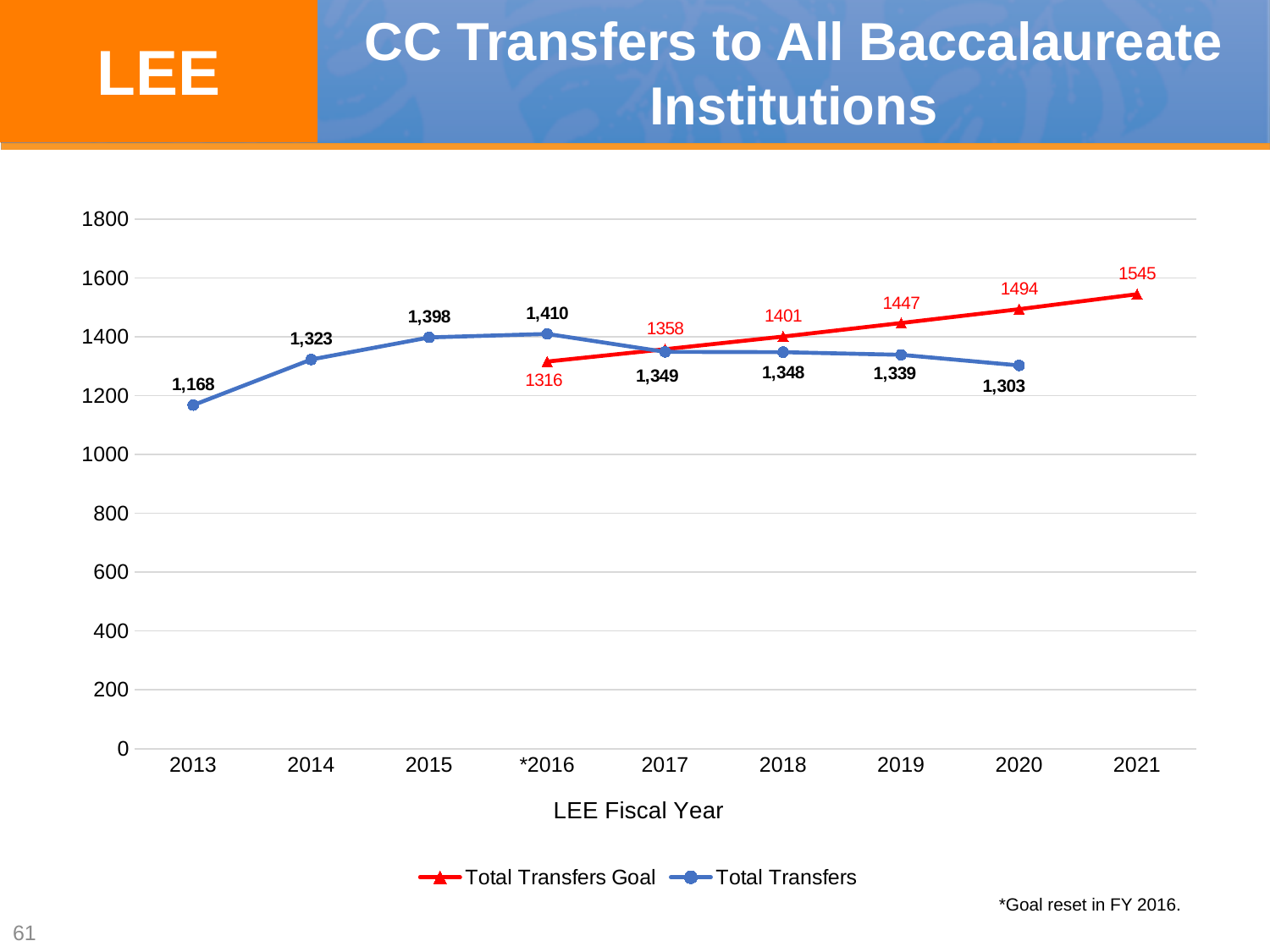
What is the Total Transfers value for 2013? 1,168 How many years are shown on the x axis? 9 Is the Total Transfers value for 2015 greater or less than 1200? greater What kind of chart is shown on the slide? Line chart How many series does the legend list? 2 In which year is Total Transfers lowest? 2013 Which is larger in 2019, Total Transfers Goal or Total Transfers? Total Transfers Goal In which year is Total Transfers highest? *2016 What is the difference between the Total Transfers Goal and Total Transfers in 2020? 191 What is the Total Transfers value for 2020? 1,303 What is the Total Transfers Goal value for 2021? 1545 What is the Total Transfers Goal value for *2016? 1316